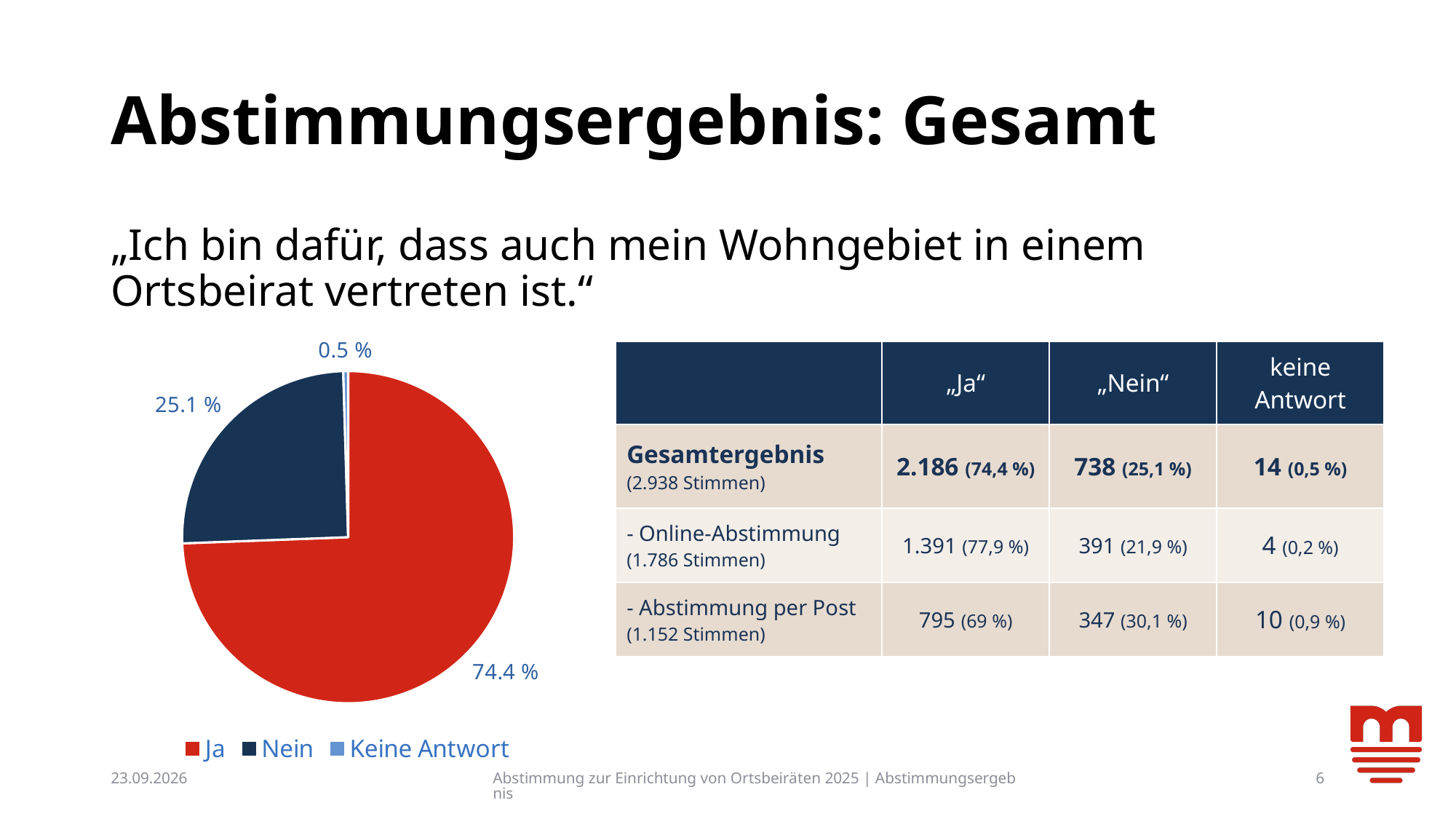
What colour is the "Ja" slice in the pie chart? Red How many entries does the legend of the pie chart list? 3 What share of the pie does the "Nein" slice represent? 25.1 % What is the difference in percentage points between the "Ja" slice and the "Nein" slice? 49.3 % What colour is the "Nein" slice in the pie chart? Dark blue Which slice of the pie chart is the smallest? Keine Antwort What share of the pie does the "Ja" slice represent? 74.4 % How many slices does the pie chart have? 3 What kind of chart is shown on the slide? Pie chart What share of the pie does the "Keine Antwort" slice represent? 0.5 % Which slice of the pie chart is the largest? Ja Which is larger in the pie chart, the "Ja" slice or the "Nein" slice? Ja